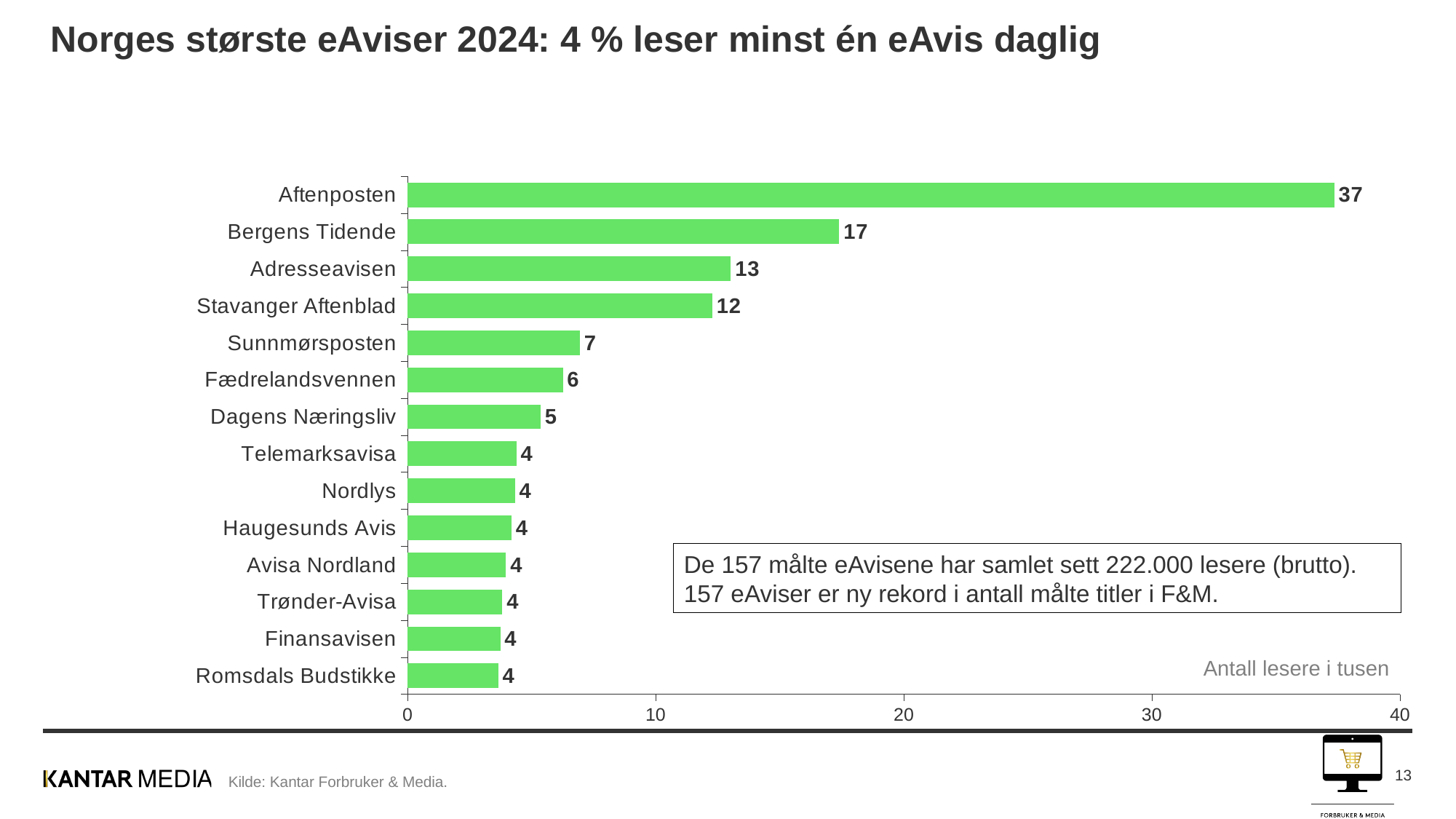
What kind of chart is shown on the slide? bar chart What unit label is shown at the bottom right of the chart? Antall lesere i tusen Which is larger, the value for Sunnmørsposten or the value for Fædrelandsvennen? Sunnmørsposten What is the value for Dagens Næringsliv? 5 How many newspapers are shown in the chart? 14 What is the difference between the values for Adresseavisen and Sunnmørsposten? 6 What is the value for Bergens Tidende? 17 Is the value for Adresseavisen greater or less than 10? greater What is the value for Stavanger Aftenblad? 12 Which newspaper has the highest value? Aftenposten What is the difference between the values for Aftenposten and Bergens Tidende? 20 What is the value for Aftenposten? 37